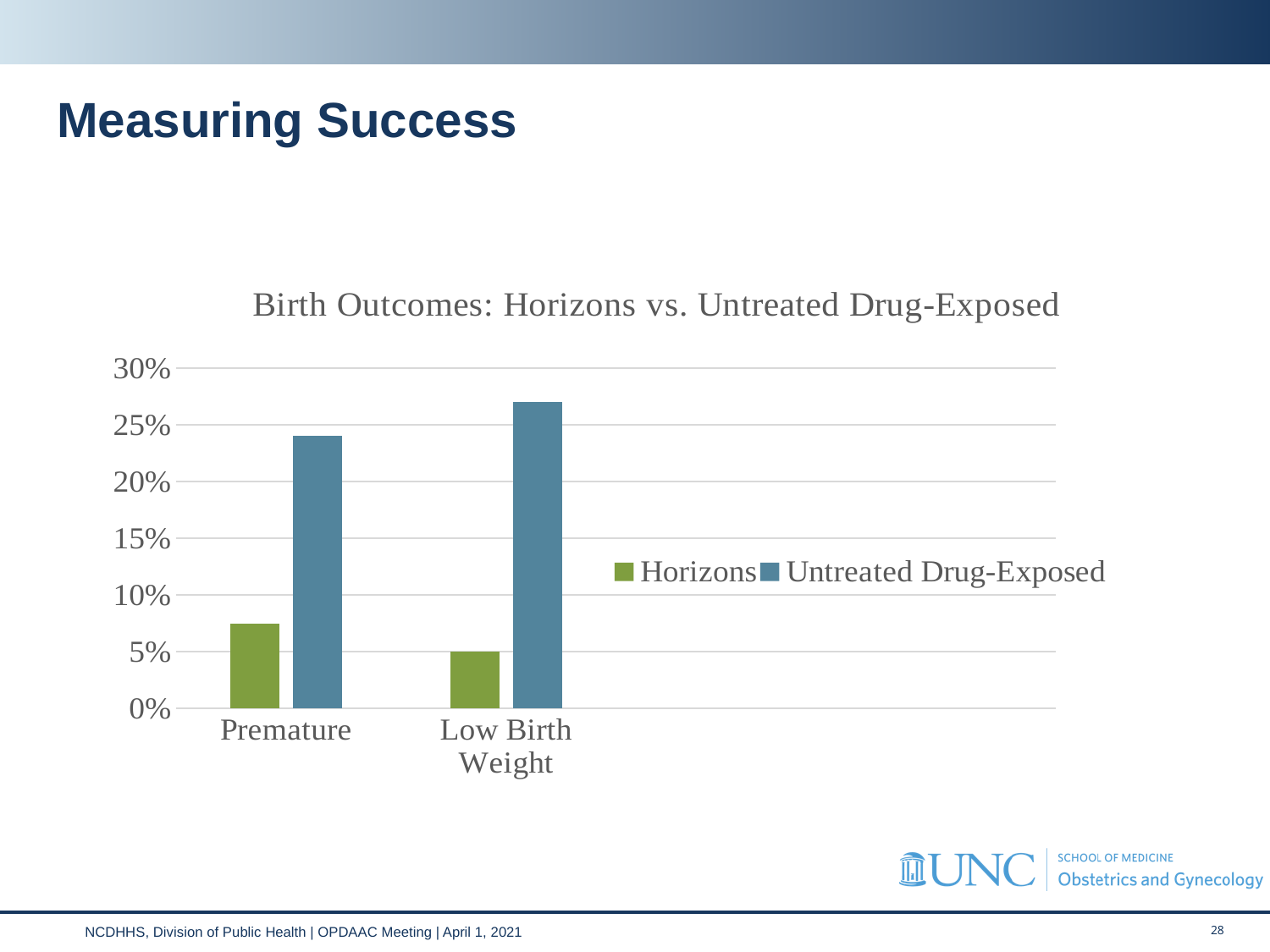
Is the Untreated Drug-Exposed value for Premature greater or less than 20%? greater Is the Horizons value for Low Birth Weight greater or less than 10%? less How many categories are shown on the x axis? 2 For Premature, which series has the larger value, Horizons or Untreated Drug-Exposed? Untreated Drug-Exposed Which category has the highest Untreated Drug-Exposed value? Low Birth Weight Which category has the lowest Horizons value? Low Birth Weight Is the Horizons value for Premature greater or less than 10%? less What type of chart is shown on the slide? bar chart What is the title of the chart? Birth Outcomes: Horizons vs. Untreated Drug-Exposed Which series is shown in green? Horizons How many series does the legend list? 2